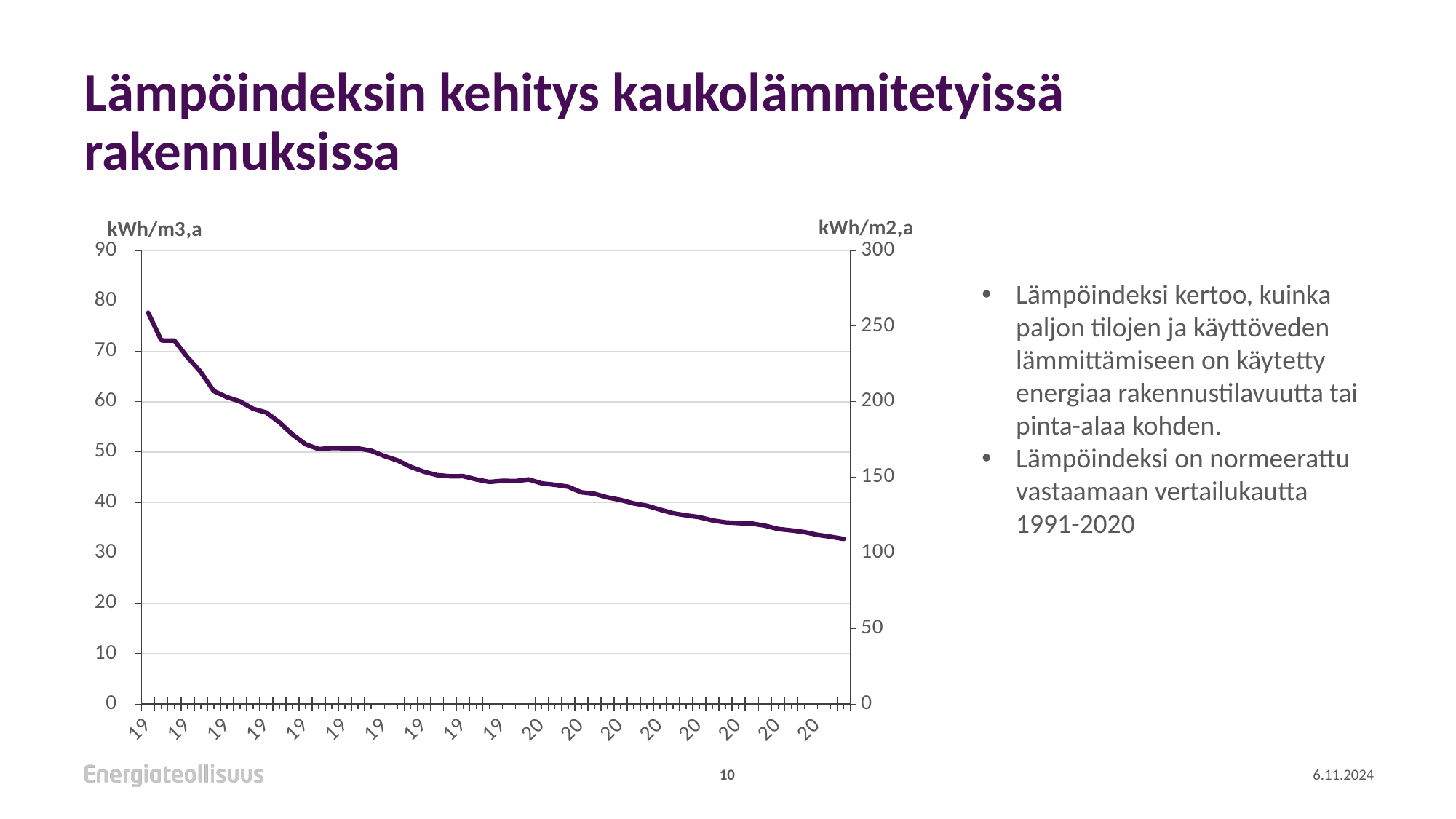
Is the value at the first (leftmost) point of the line greater or less than 80 on the left axis? less Which is larger, the value at the leftmost point of the line or the value at the rightmost point? the leftmost point Is the value at the first (leftmost) point of the line greater or less than 70 on the left axis? greater What kind of chart is shown on the slide? line chart What is the unit label shown above the left vertical axis of the chart? kWh/m3,a Is the value at the last (rightmost) point of the line greater or less than 40 on the left axis? less Do the values in the chart rise or fall from left to right along the x axis? fall What is the unit label shown above the right vertical axis of the chart? kWh/m2,a What is the highest tick value shown on the right vertical axis? 300